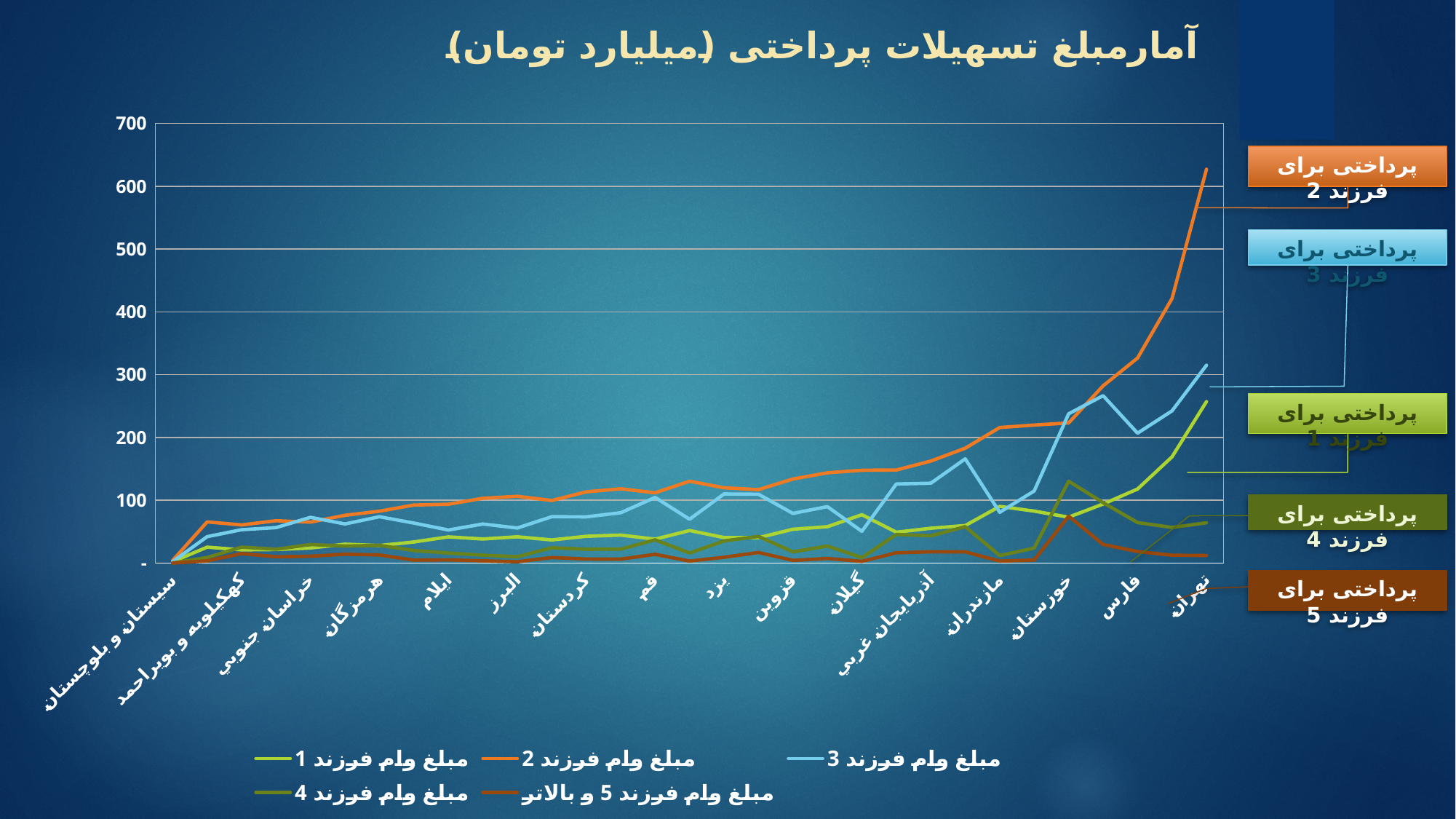
Which province has the lowest value for the series مبلغ وام فرزند 2? سیستان و بلوچستان What kind of chart is shown on the slide? line chart Is the value of مبلغ وام فرزند 3 for تهران greater or less than 300? greater Do the values of مبلغ وام فرزند 2 generally rise or fall from سیستان و بلوچستان to تهران along the x axis? rise For تهران, which series has the larger value: مبلغ وام فرزند 2 or مبلغ وام فرزند 3? مبلغ وام فرزند 2 Is the value of مبلغ وام فرزند 2 for تهران greater or less than 600? greater What is the title of the chart? آمارمبلغ تسهیلات پرداختی (میلیارد تومان) How many series does the legend list? 5 Is the value of مبلغ وام فرزند 2 for فارس greater or less than 300? greater Which province has the highest value for the series مبلغ وام فرزند 2? تهران